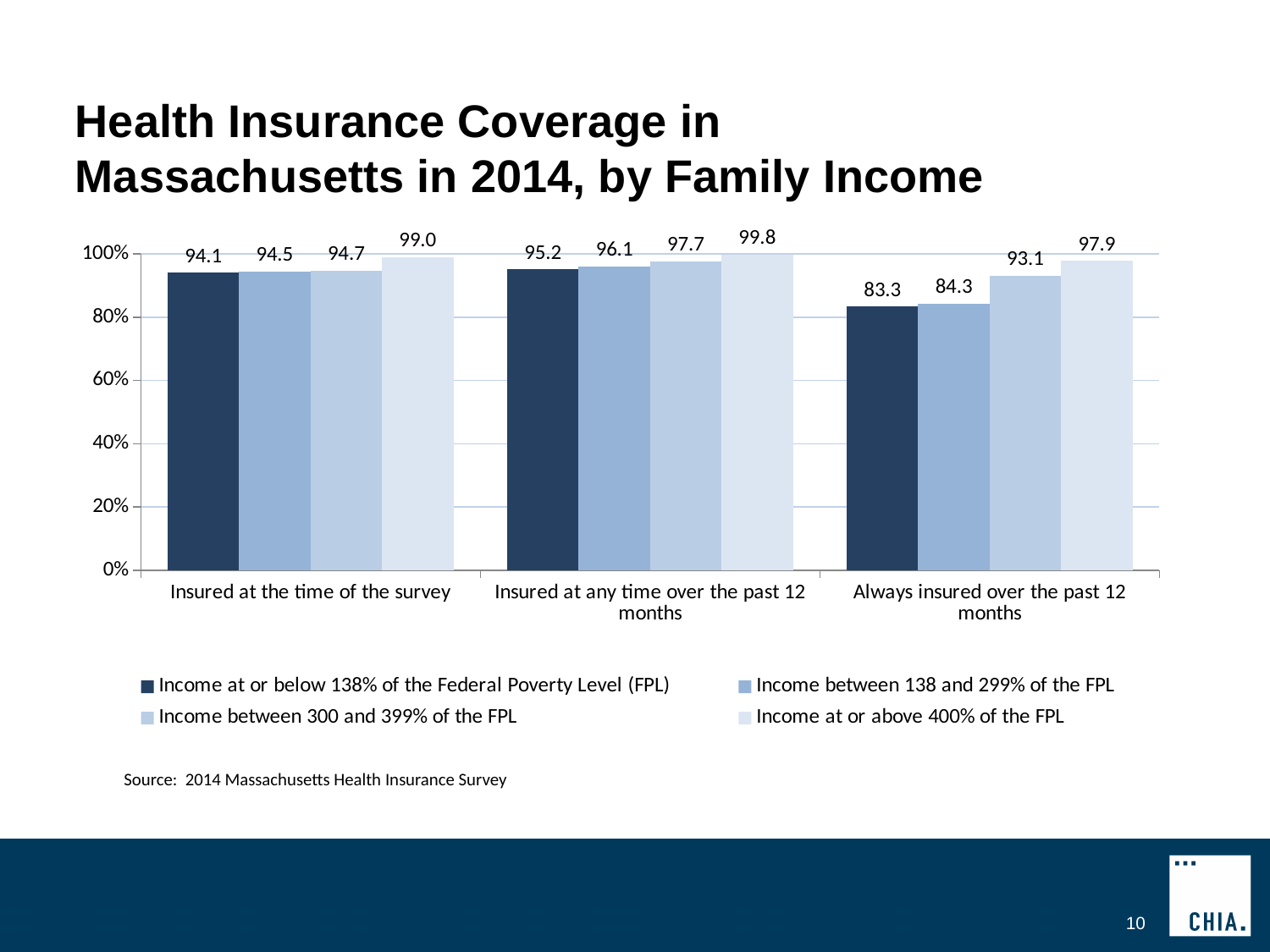
What is the value for 'Income at or below 138% of the Federal Poverty Level (FPL)' in the 'Always insured over the past 12 months' category? 83.3 Which is larger: the 'Income between 300 and 399% of the FPL' value for 'Insured at the time of the survey' or for 'Insured at any time over the past 12 months'? Insured at any time over the past 12 months What is the difference between the 'Income at or above 400% of the FPL' and 'Income at or below 138% of the Federal Poverty Level (FPL)' values in the 'Always insured over the past 12 months' category? 14.6 Which income group has the lowest value in the 'Always insured over the past 12 months' category? Income at or below 138% of the Federal Poverty Level (FPL) What kind of chart is shown on the slide? Bar chart Which income group has the highest value in the 'Insured at any time over the past 12 months' category? Income at or above 400% of the FPL Is the value for 'Income between 138 and 299% of the FPL' in the 'Always insured over the past 12 months' category greater or less than 80%? greater What is the value for 'Income between 138 and 299% of the FPL' in the 'Insured at any time over the past 12 months' category? 96.1 What is the value for 'Income at or above 400% of the FPL' in the 'Insured at the time of the survey' category? 99.0 How many categories are shown on the x axis? 3 What is the source cited below the chart? 2014 Massachusetts Health Insurance Survey How many series does the legend list? 4